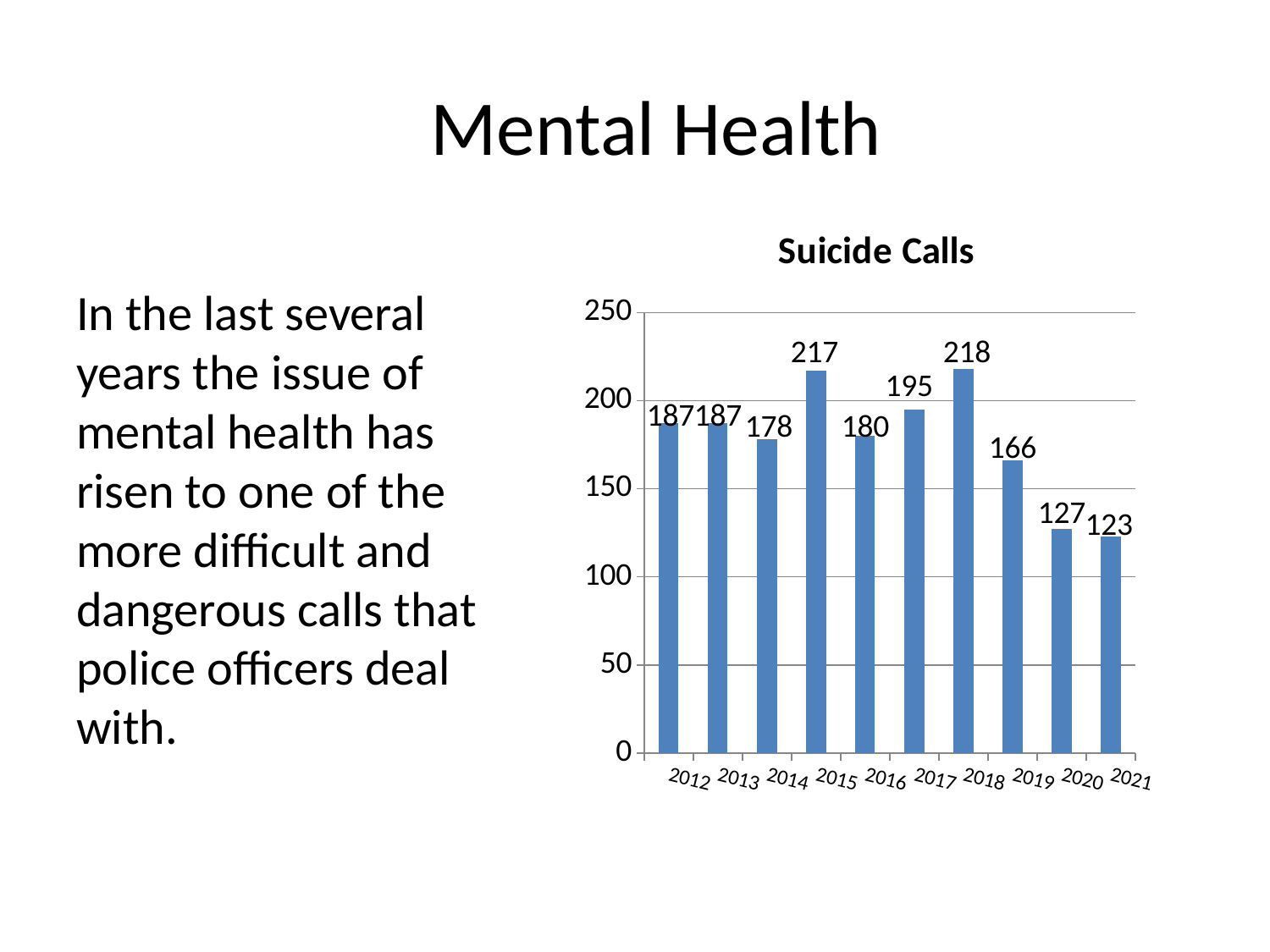
What is the difference between the values for 2015 and 2014? 39 Is the value for 2020 greater or less than 150? less Which year has the highest number of suicide calls? 2018 How many suicide calls are shown for 2019? 166 What is the value for 2015 in the Suicide Calls chart? 217 What is the title of the chart on the slide? Suicide Calls What is the difference between the suicide calls in 2018 and 2021? 95 Which year has the lowest number of suicide calls? 2021 What kind of chart is used to show the suicide calls? bar chart Which year has more suicide calls, 2016 or 2017? 2017 How many years are shown in the Suicide Calls chart? 10 What is the value for 2021 in the Suicide Calls chart? 123